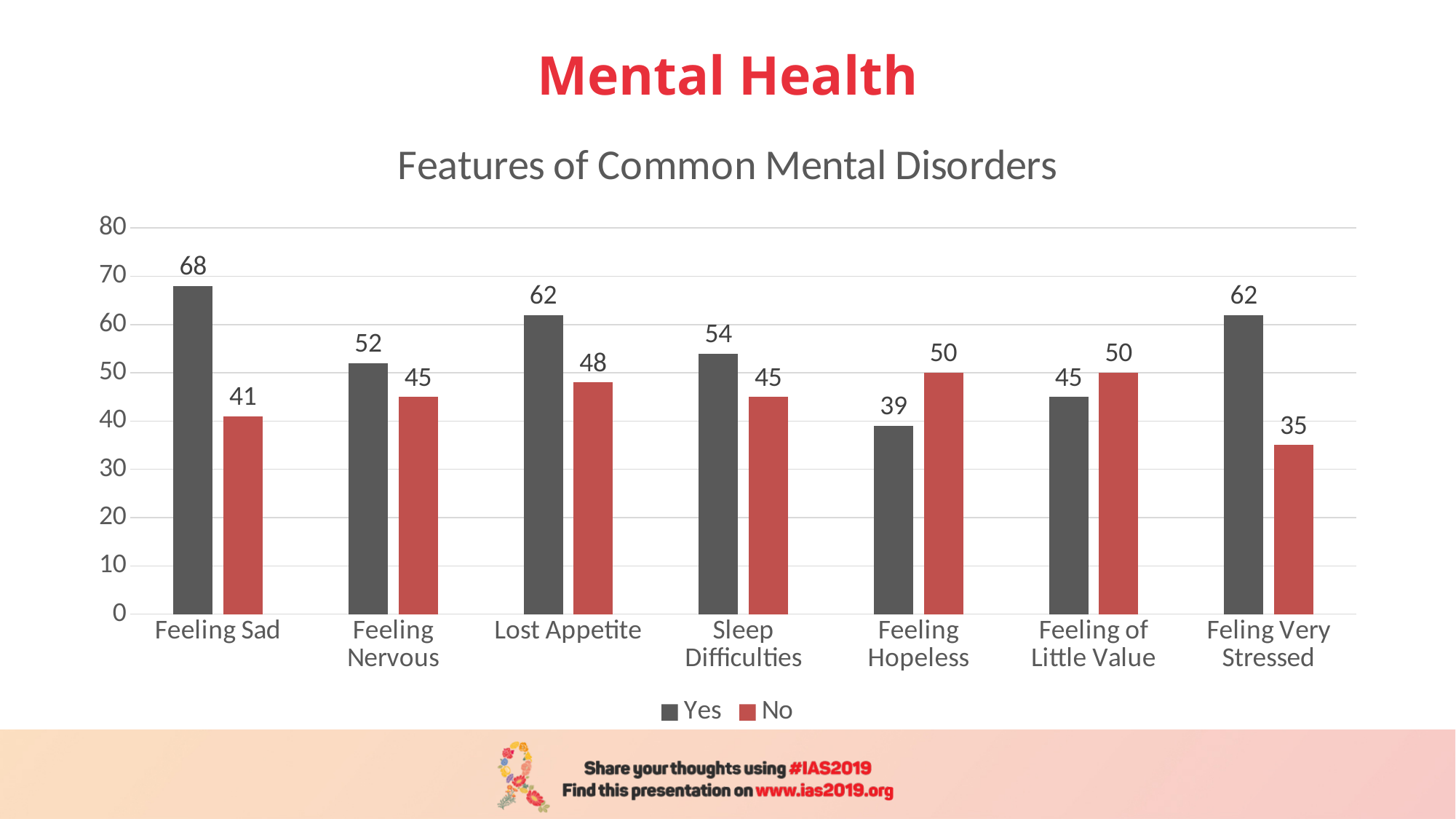
What is the No value for Feling Very Stressed? 35 Which is larger for Feeling of Little Value, the Yes value or the No value? No Which category has the lowest No value? Feling Very Stressed What is the difference between the Yes and No values for Feeling Sad? 27 Is the Yes value for Lost Appetite greater or less than 60? greater What is the Yes value for Feeling Sad? 68 Which category has the highest Yes value? Feeling Sad What is the No value for Feeling Hopeless? 50 What is the title of the chart? Features of Common Mental Disorders How many series does the legend list? 2 What kind of chart is shown on the slide? bar chart How many categories are shown on the x axis? 7